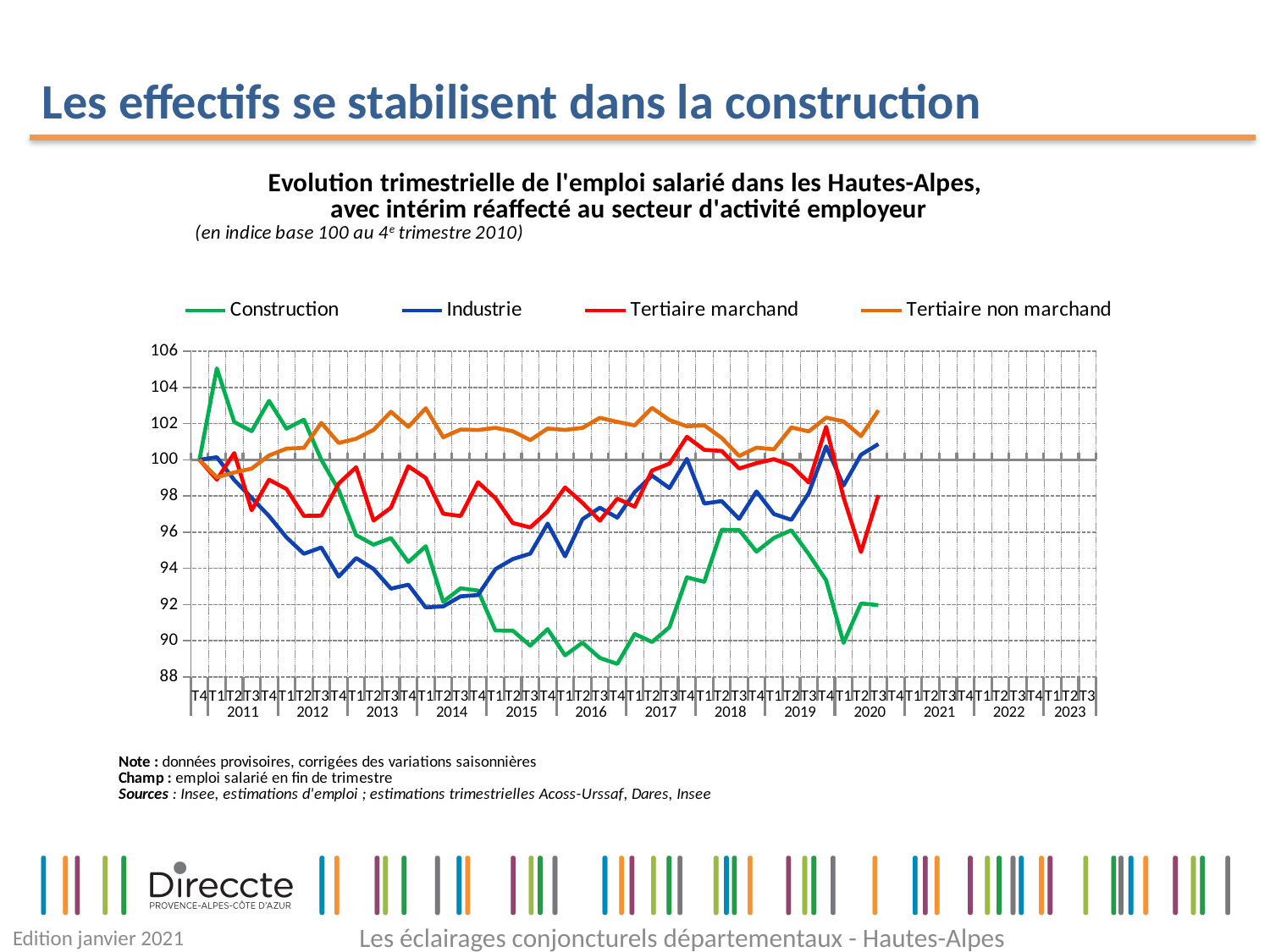
What kind of chart is shown on the slide? line chart Is the value for Industrie at T1 2014 greater or less than 94? less Does the Construction series rise or fall overall between T1 2011 and T4 2016? fall Which series has the highest value at T1 2011? Construction At T2 2020, which is larger: Construction or Tertiaire marchand? Tertiaire marchand According to the subtitle, which quarter is the base 100 of the index? 4e trimestre 2010 Is the value for Construction at T4 2016 greater or less than 90? less How many series does the legend list? 4 Which series has the lowest value at T4 2016? Construction Which series are listed in the legend? Construction, Industrie, Tertiaire marchand, Tertiaire non marchand Is the value for Tertiaire marchand at T2 2020 greater or less than 96? less